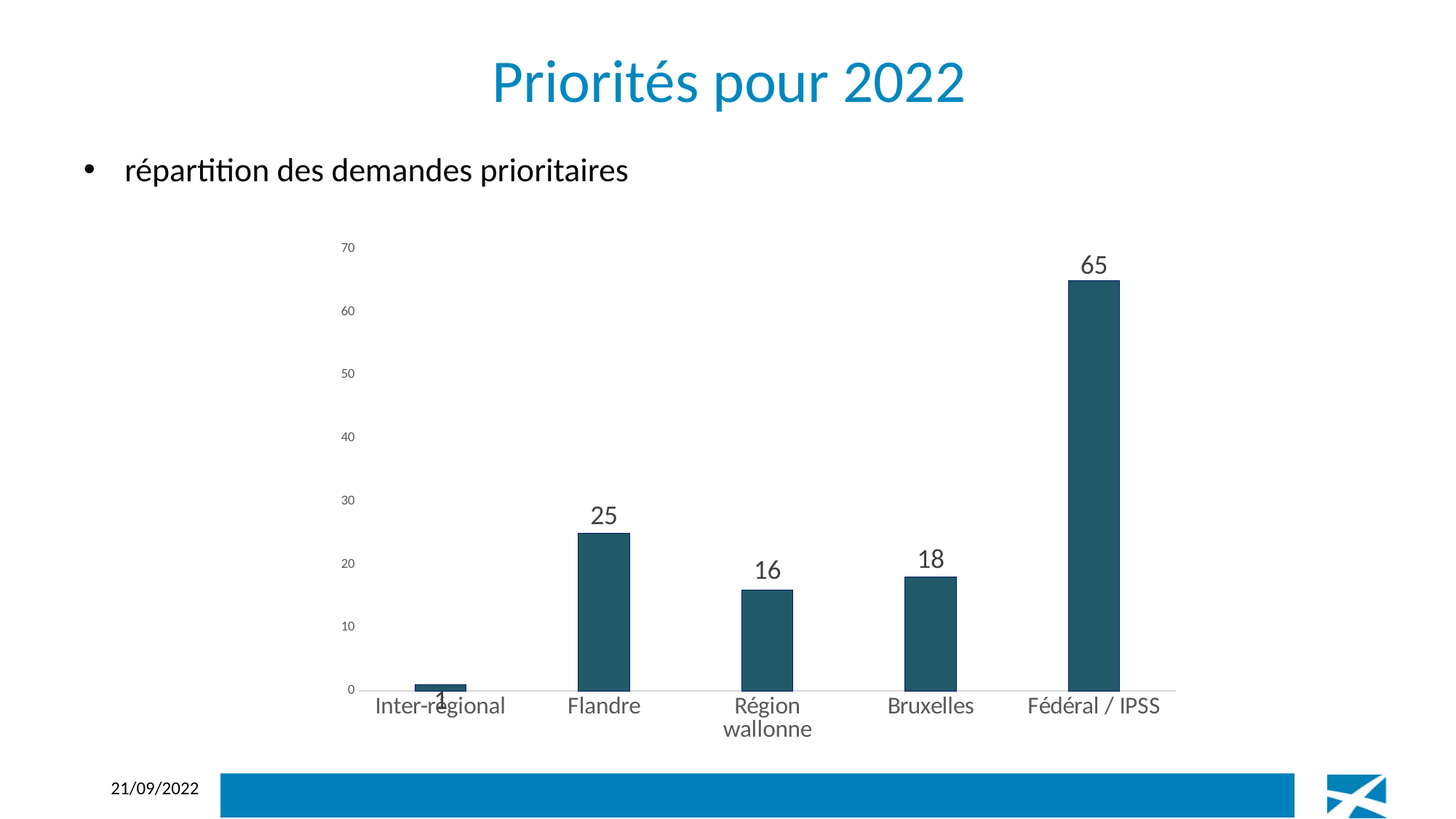
Which category has the lowest value? Inter-régional What is the difference between the values for Fédéral / IPSS and Flandre? 40 How many categories are shown on the x axis? 5 Which is larger, the value for Bruxelles or the value for Région wallonne? Bruxelles What is the title of the slide containing the chart? Priorités pour 2022 What is the value for Région wallonne? 16 What is the value for Flandre? 25 Is the value for Fédéral / IPSS greater or less than 60? greater What is the value for Bruxelles? 18 What is the value for Fédéral / IPSS? 65 What kind of chart is shown on the slide? bar chart Which category has the highest value? Fédéral / IPSS